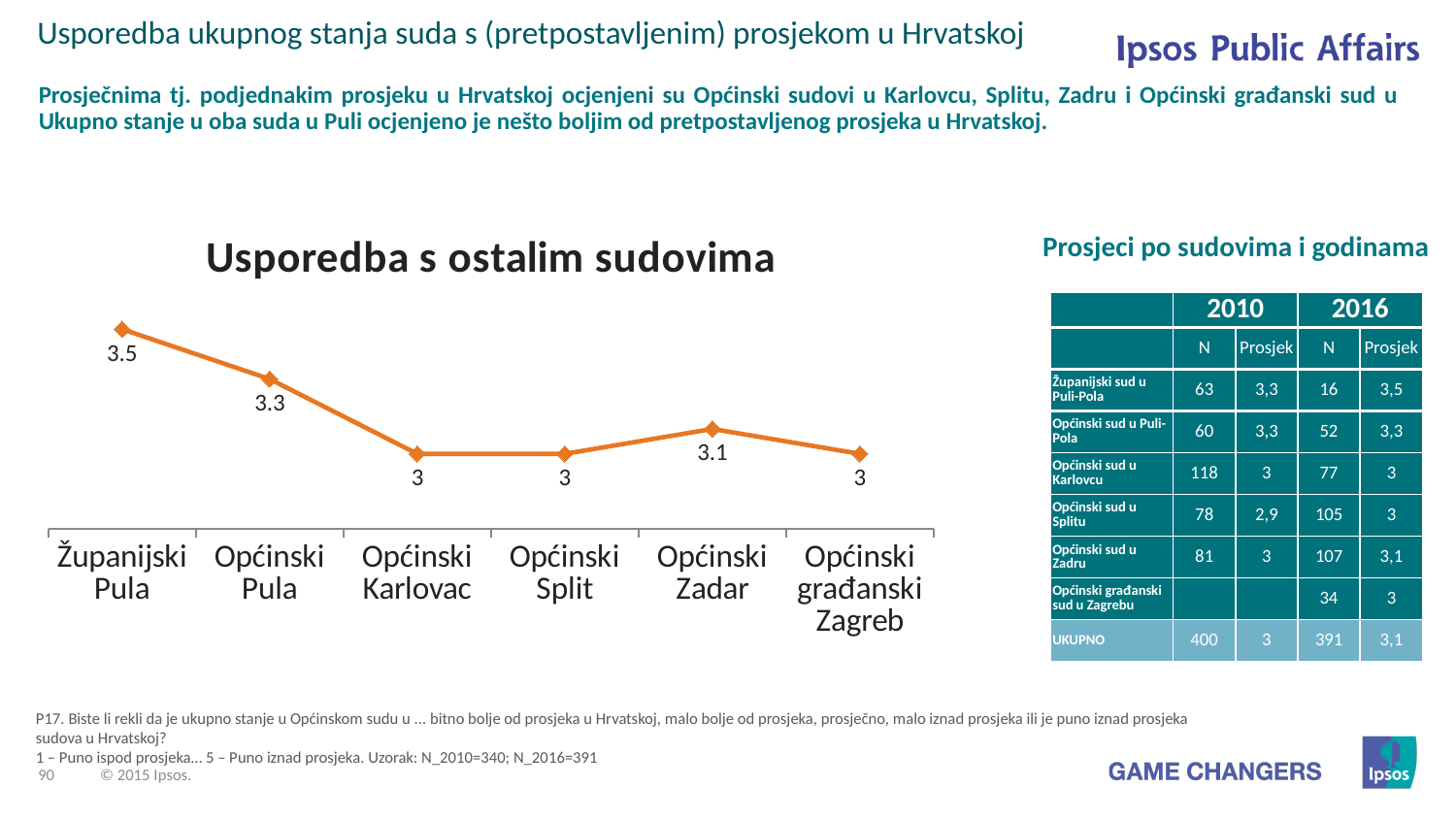
What is the value for Općinski građanski Zagreb in the chart 'Usporedba s ostalim sudovima'? 3 How many categories are plotted in the chart 'Usporedba s ostalim sudovima'? 6 What is the value for Općinski Pula in the chart 'Usporedba s ostalim sudovima'? 3.3 What is the title of the chart on the left side of the slide? Usporedba s ostalim sudovima What is the value for Općinski Zadar in the chart 'Usporedba s ostalim sudovima'? 3.1 What is the value for Općinski Karlovac in the chart 'Usporedba s ostalim sudovima'? 3 What is the difference between the values for Općinski Zadar and Općinski Split in the chart 'Usporedba s ostalim sudovima'? 0.1 In the chart 'Usporedba s ostalim sudovima', which is larger: the value for Općinski Pula or the value for Općinski Zadar? Općinski Pula What kind of chart is 'Usporedba s ostalim sudovima'? Line chart Which category has the highest value in the chart 'Usporedba s ostalim sudovima'? Županijski Pula What is the difference between the values for Županijski Pula and Općinski Pula in the chart 'Usporedba s ostalim sudovima'? 0.2 What is the value for Županijski Pula in the chart 'Usporedba s ostalim sudovima'? 3.5